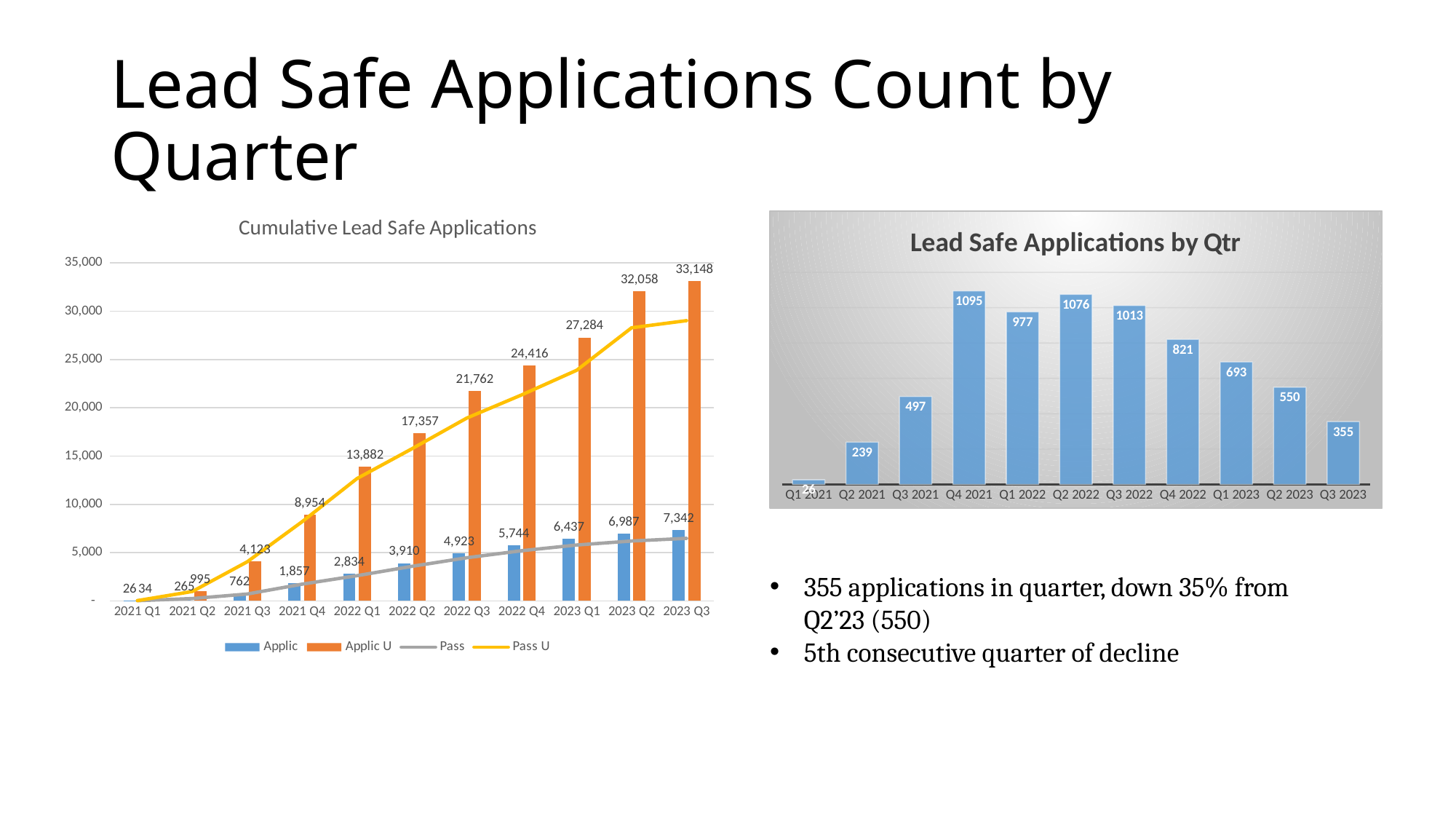
In the 'Lead Safe Applications by Qtr' chart, which quarter has the highest value? Q4 2021 In the 'Cumulative Lead Safe Applications' chart, what is the Applic value for 2022 Q2? 3,910 In the 'Lead Safe Applications by Qtr' chart, what is the difference between Q2 2023 and Q3 2023? 195 In the 'Cumulative Lead Safe Applications' chart, what is the Applic U value for 2023 Q3? 33,148 In the 'Lead Safe Applications by Qtr' chart, which quarter has the lowest value? Q1 2021 In the 'Cumulative Lead Safe Applications' chart, which is larger for 2023 Q1: Applic or Applic U? Applic U In the 'Lead Safe Applications by Qtr' chart, what is the value for Q4 2021? 1095 In the 'Cumulative Lead Safe Applications' chart, how many series does the legend list? 4 What kind of chart is 'Lead Safe Applications by Qtr'? bar chart In the 'Lead Safe Applications by Qtr' chart, how many quarters are shown? 11 In the 'Cumulative Lead Safe Applications' chart, what is the difference between the Applic U values for 2023 Q2 and 2023 Q1? 4,774 In the 'Lead Safe Applications by Qtr' chart, do the values rise or fall from Q2 2022 to Q3 2023? fall